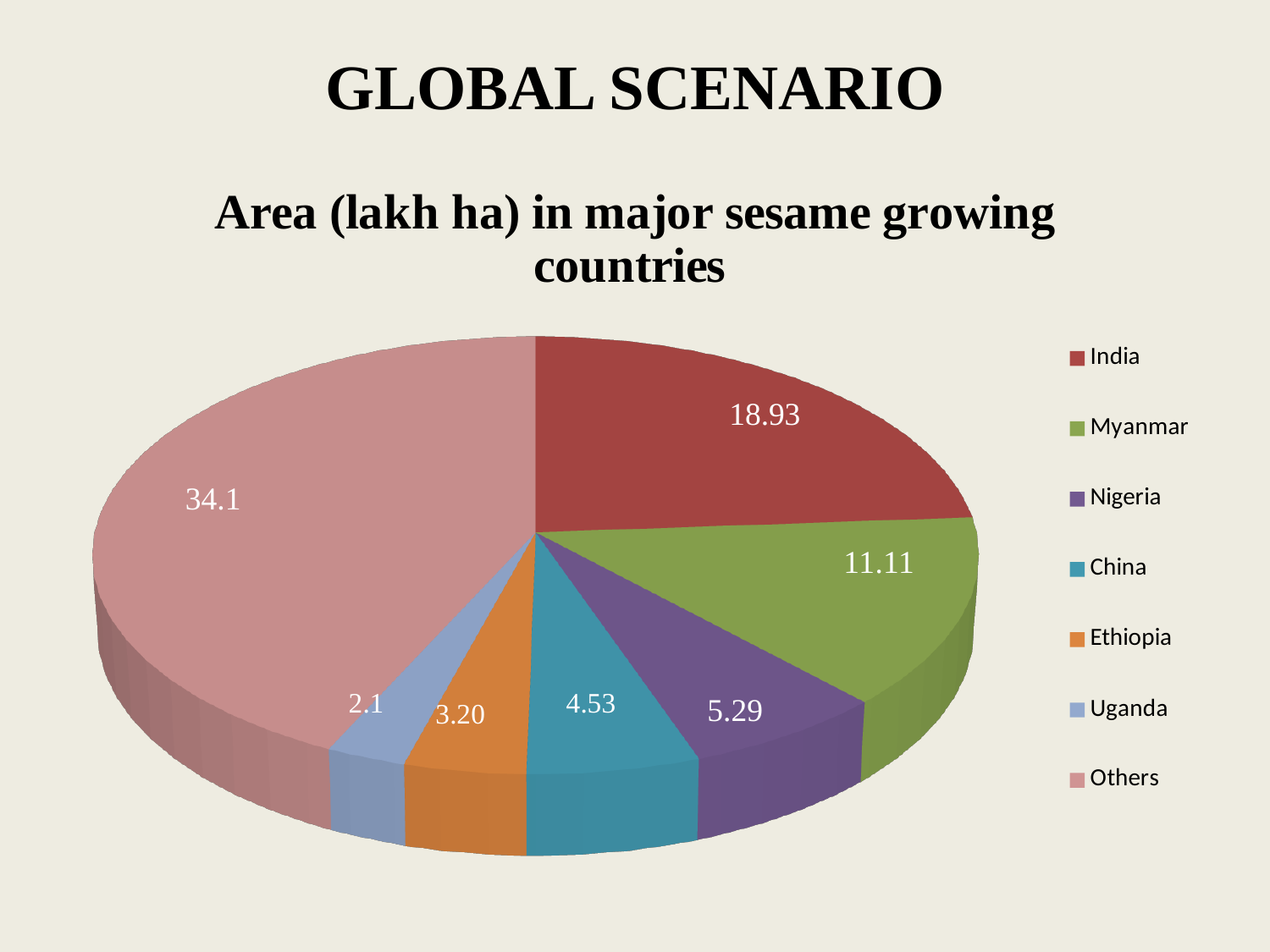
Which has a larger value, Nigeria or China? Nigeria What is the area (lakh ha) for Myanmar? 11.11 How many slices does the pie chart have? 7 What is the title of the chart? Area (lakh ha) in major sesame growing countries What value is shown for Uganda? 2.1 What is the difference between the values for India and Myanmar? 7.82 What is the difference between the values for Nigeria and China? 0.76 What value is shown for Ethiopia? 3.20 Which slice of the pie chart has the largest value? Others Which country has the smallest area in the pie chart? Uganda What is the area (lakh ha) for India in the pie chart? 18.93 What type of chart is shown on the slide? Pie chart